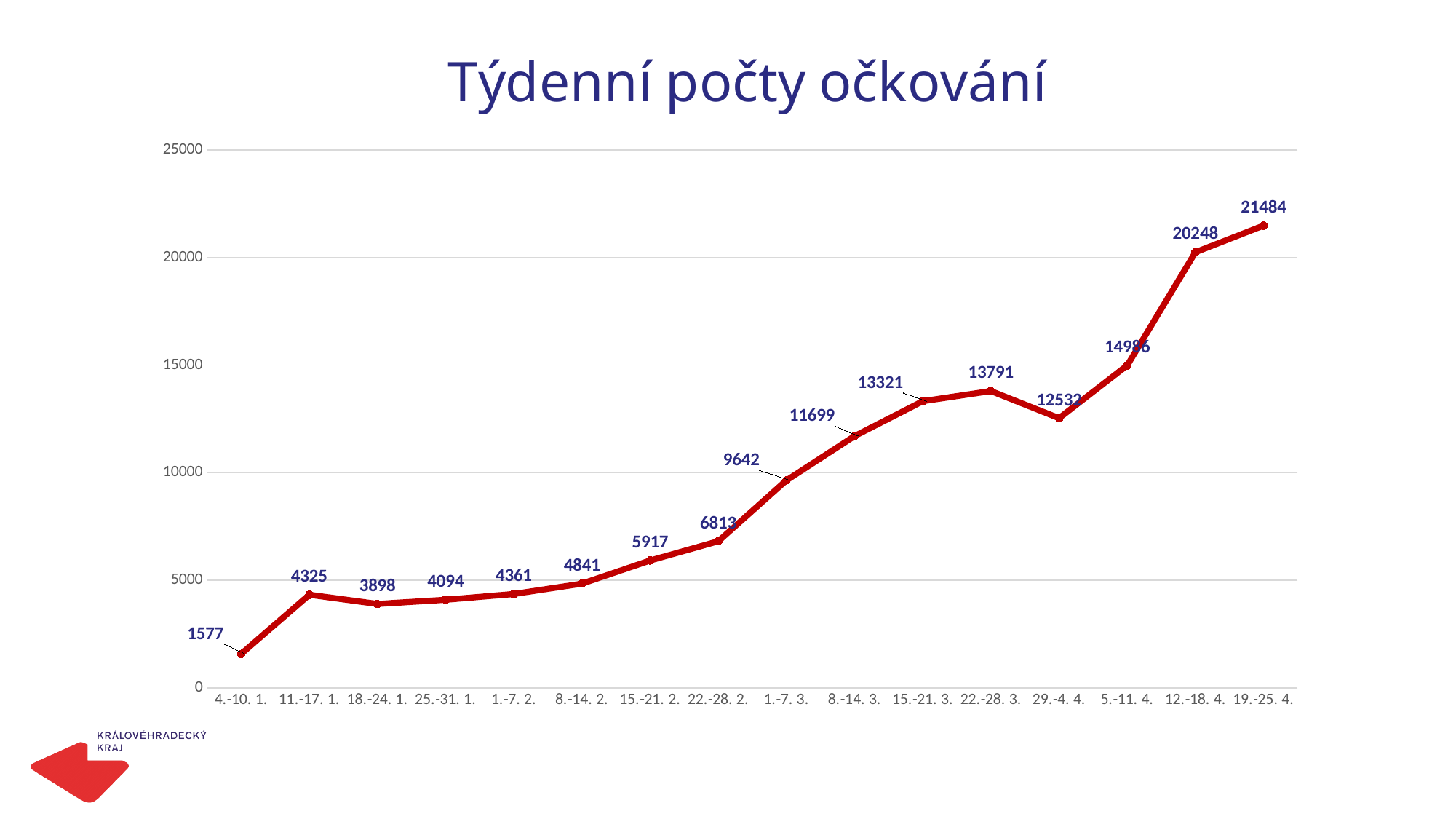
What is the value for the week 4.-10. 1.? 1577 Is the value for 1.-7. 3. greater or less than 10000? less What is the difference between the values for 12.-18. 4. and 19.-25. 4.? 1236 What is the title of the chart? Týdenní počty očkování Do the values generally rise or fall from left to right along the x axis? rise Which week has the lowest value? 4.-10. 1. What kind of chart is shown on the slide? line chart Which week has the highest value? 19.-25. 4. Which is larger, the value for 22.-28. 3. or the value for 29.-4. 4.? 22.-28. 3. What is the value for the week 19.-25. 4.? 21484 How many weeks are plotted on the x axis? 16 What is the value for the week 22.-28. 2.? 6813